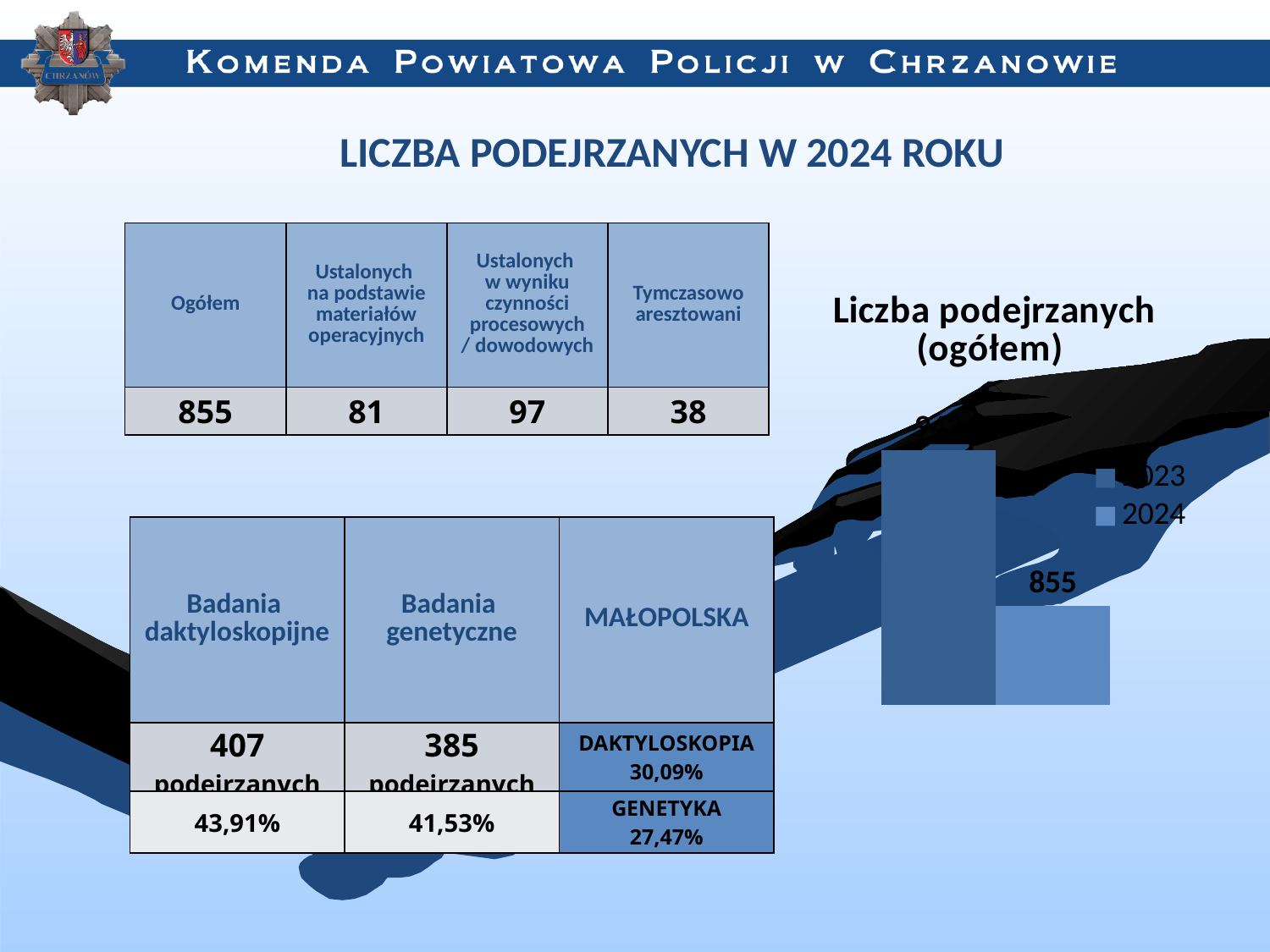
How many series does the legend of the chart 'Liczba podejrzanych (ogółem)' list? 2 What is the title of the chart on the slide? Liczba podejrzanych (ogółem) In the chart 'Liczba podejrzanych (ogółem)', does the number of suspects rise or fall from 2023 to 2024? fall How many bars are plotted in the chart 'Liczba podejrzanych (ogółem)'? 2 In the chart 'Liczba podejrzanych (ogółem)', what is the value for 2024? 855 In the chart 'Liczba podejrzanych (ogółem)', which year has the higher value? 2023 What kind of chart is shown on the right side of the slide? bar chart Which years are listed in the legend of the chart 'Liczba podejrzanych (ogółem)'? 2023 and 2024 In the chart 'Liczba podejrzanych (ogółem)', is the bar for 2023 taller or shorter than the bar for 2024? taller In the chart 'Liczba podejrzanych (ogółem)', which year has the lower value? 2024